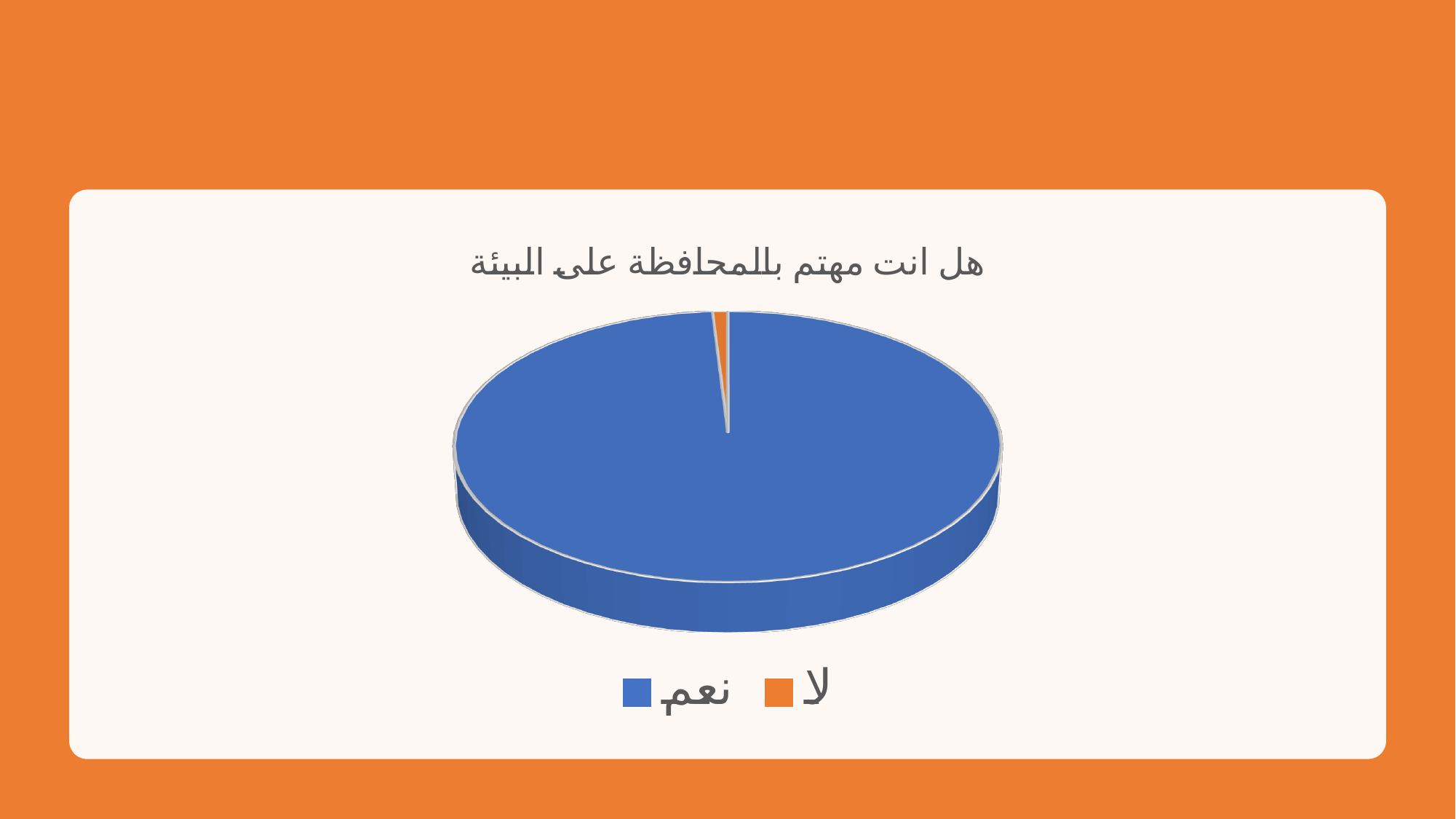
What colour represents the category لا in the pie chart? orange What is the title of the chart? هل انت مهتم بالمحافظة على البيئة What kind of chart is shown on the slide? pie chart Which category has the largest slice of the pie? نعم Which category has the smallest slice of the pie? لا How many categories (slices) does the pie chart have? 2 Which slice is larger, نعم or لا? نعم How many entries does the legend list? 2